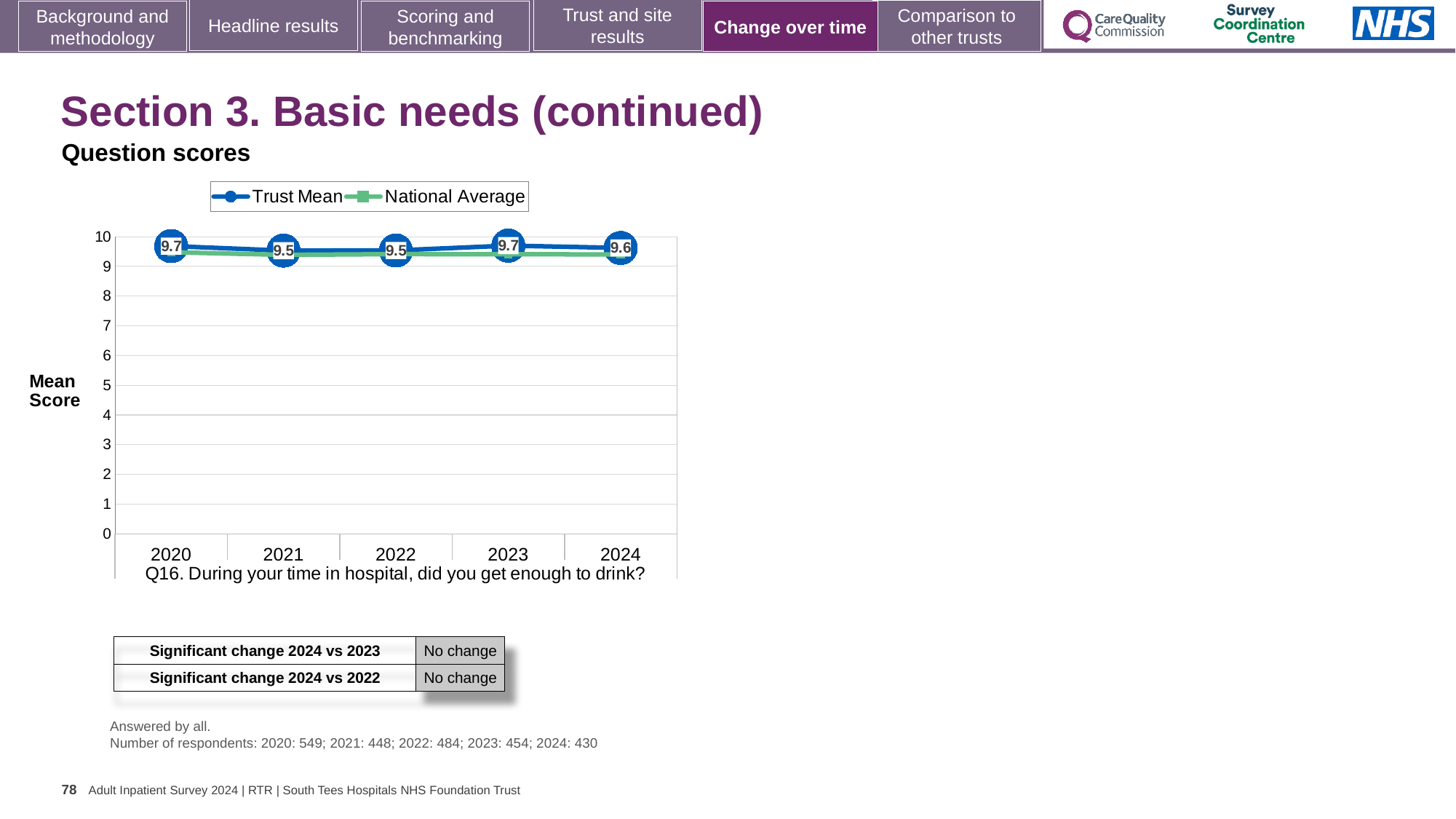
What kind of chart is shown on the slide? line chart What is the Trust Mean score for 2022? 9.5 What is the difference between the Trust Mean scores for 2020 and 2021? 0.2 What is the Trust Mean score for 2020? 9.7 Is the National Average value for 2024 greater or less than 9? greater Does the Trust Mean score rise or fall from 2022 to 2023? rise How many years are shown on the x axis of the chart? 5 What are the two series named in the chart legend? Trust Mean and National Average What is the label on the y axis of the chart? Mean Score How many series does the chart legend list? 2 What is the Trust Mean score for 2024? 9.6 Which year has the larger Trust Mean score, 2022 or 2023? 2023